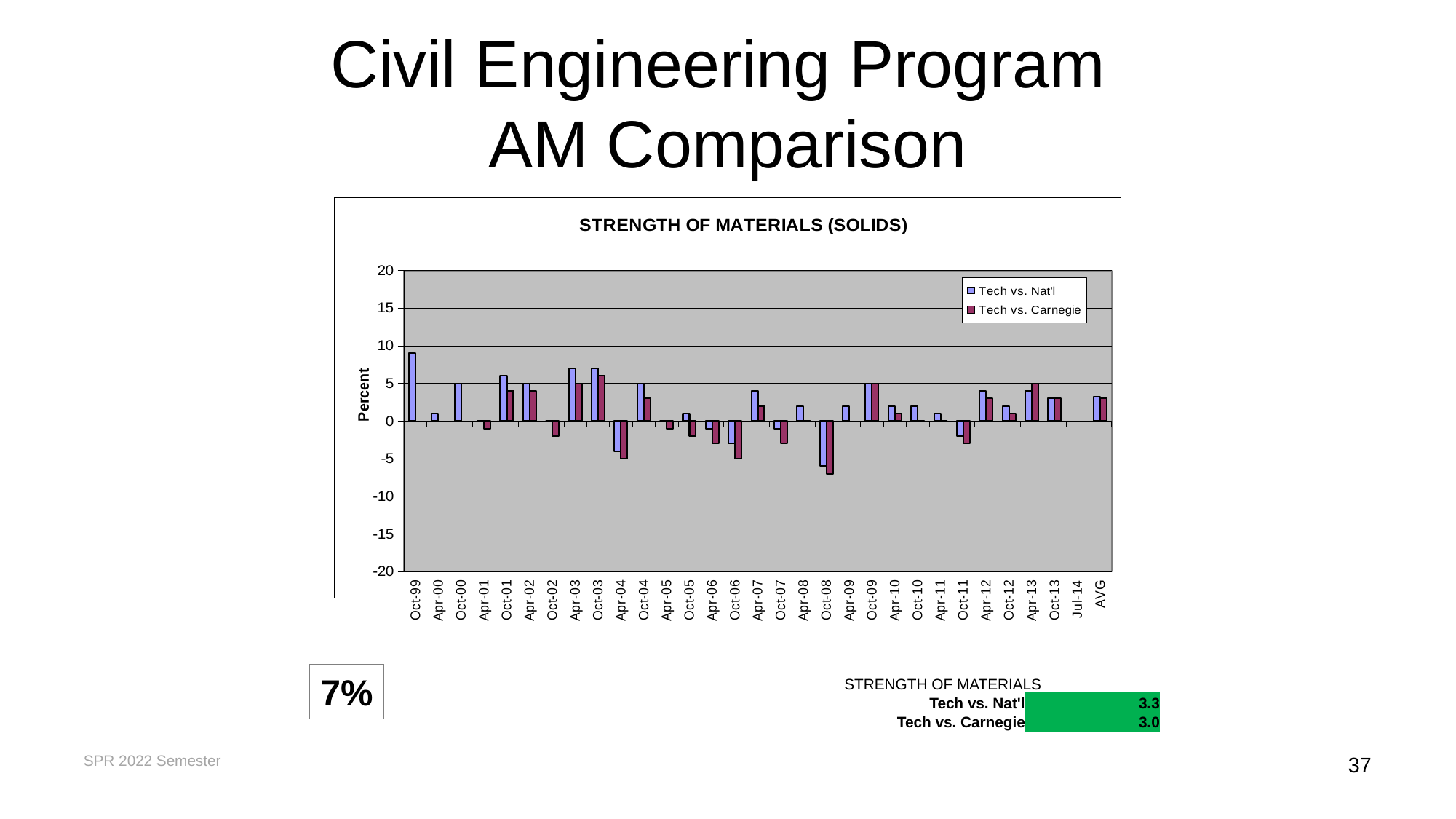
How many categories are shown along the x axis of the chart? 31 According to the table below the chart, what is the Tech vs. Nat'l value for Strength of Materials? 3.3 What is the label on the vertical axis of the chart? Percent What kind of chart is shown on the slide? bar chart For which category is the Tech vs. Carnegie bar the lowest? Oct-08 What is the title of the chart? STRENGTH OF MATERIALS (SOLIDS) According to the table below the chart, what is the Tech vs. Carnegie value for Strength of Materials? 3.0 Is the Tech vs. Nat'l value for Oct-99 greater or less than 5? greater How many series does the chart legend list? 2 What is the difference between the Tech vs. Nat'l value (3.3) and the Tech vs. Carnegie value (3.0) in the table below the chart? 0.3 Is the Tech vs. Carnegie value for Oct-08 greater or less than -5? less For which category is the Tech vs. Nat'l bar the highest? Oct-99